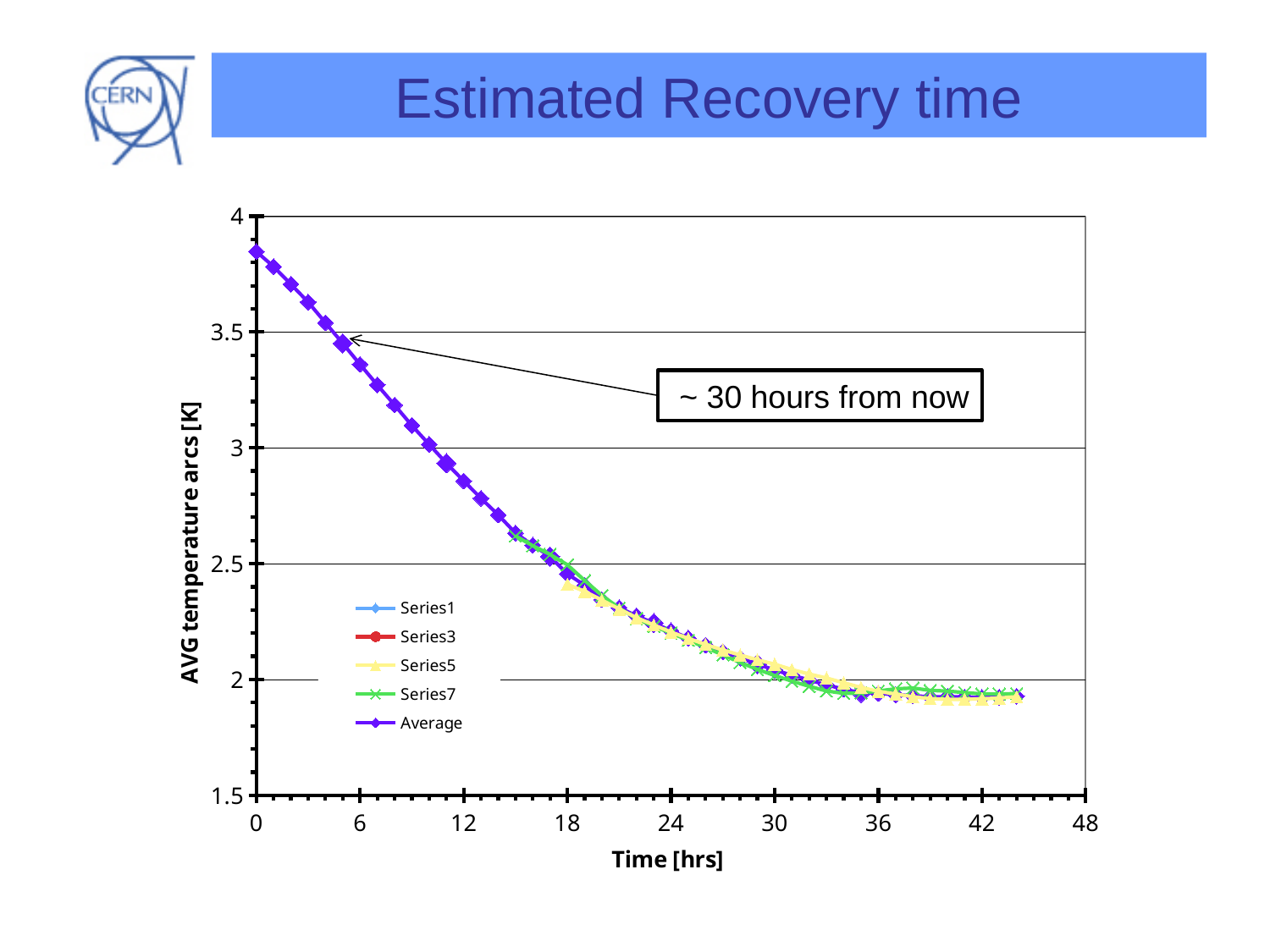
Do the plotted values rise or fall as time increases along the x axis? fall What is the label of the x axis? Time [hrs] Is the Average value at 12 hours greater or less than 3? less What kind of chart is shown on the slide? line chart What is the highest value shown on the y axis? 4 Is the Average value at 0 hours greater or less than 3.5? greater Is the Average value at 24 hours greater or less than 2.5? less Which is larger, the Average value at 6 hours or at 30 hours? 6 hours How many series does the legend list? 5 What is the label of the y axis? AVG temperature arcs [K]